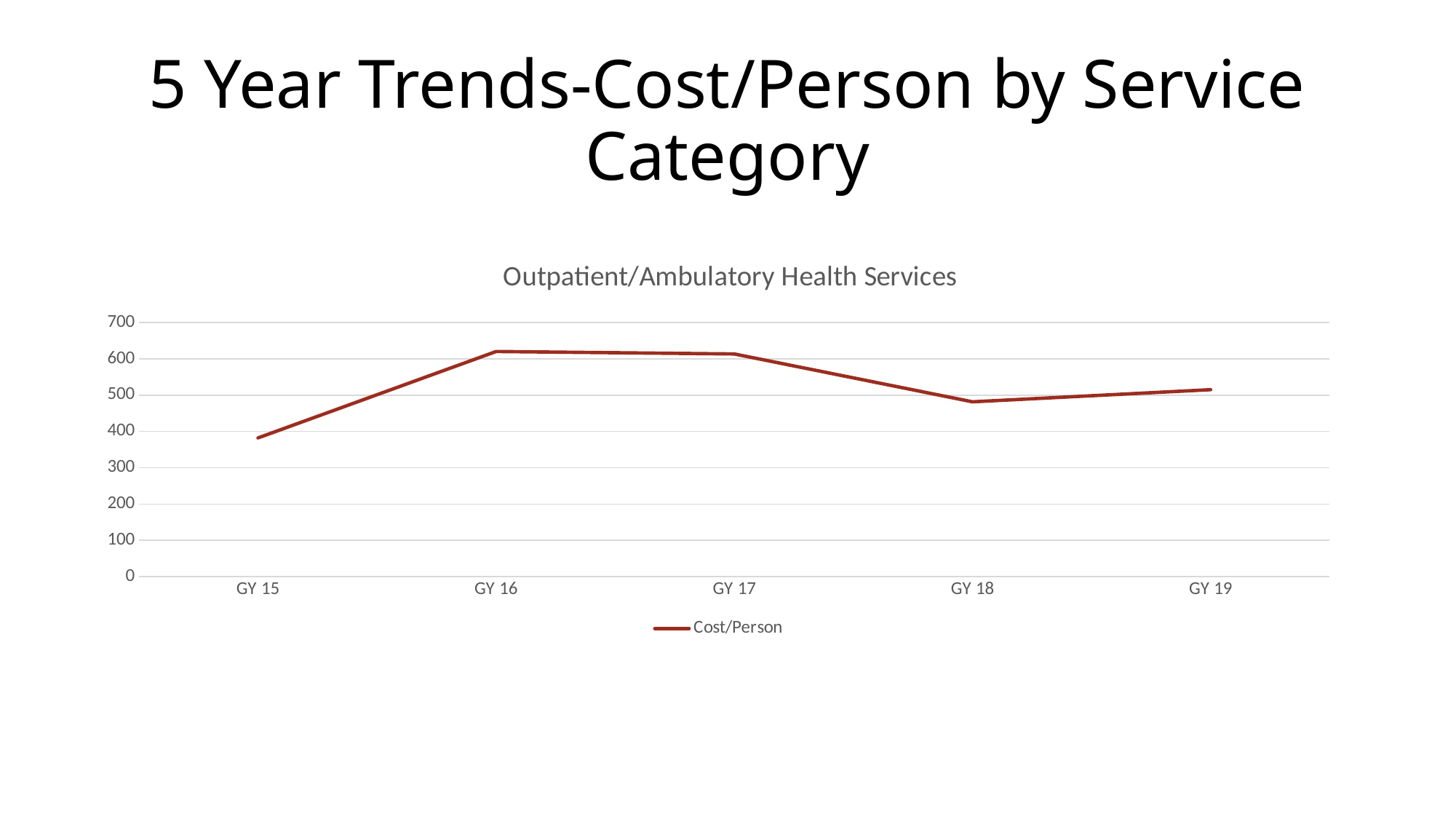
Which year has the lowest Cost/Person? GY 15 How many years are plotted along the x axis? 5 Is the Cost/Person for GY 15 greater or less than 400? less Is the Cost/Person for GY 16 greater or less than 600? greater How many series does the legend list? 1 Is the Cost/Person for GY 18 greater or less than 500? less Which is larger, the Cost/Person for GY 17 or for GY 18? GY 17 What is the name of the series shown in the legend? Cost/Person Does the Cost/Person rise or fall from GY 17 to GY 18? fall Which is larger, the Cost/Person for GY 16 or for GY 15? GY 16 What is the title of the chart? Outpatient/Ambulatory Health Services What kind of chart is shown on the slide? line chart